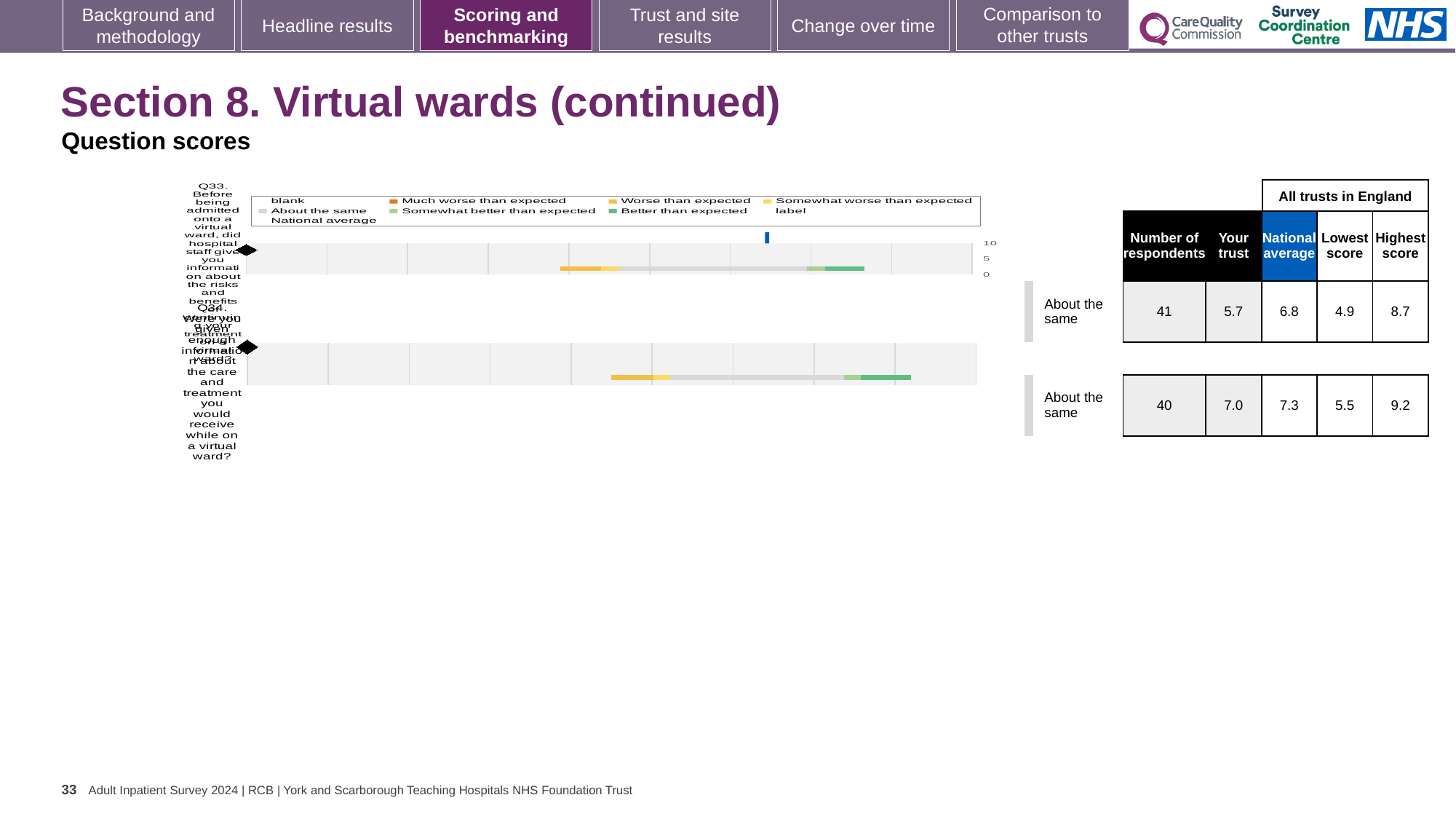
Which question has the higher 'Your trust' score, Q33 or Q34? Q34 What is the lowest score among all trusts in England for Q34? 5.5 What is the highest score among all trusts in England for Q33? 8.7 By how much does the national average for Q34 exceed the trust's score for Q34? 0.3 Which question has the larger number of respondents, Q33 or Q34? Q33 What benchmark category is shown for Q33? About the same What is the national average score for Q33? 6.8 What kind of chart is used to show the question scores? Bar chart What is the 'Your trust' score for Q34 (enough information about care and treatment on a virtual ward)? 7.0 What is the difference between the highest and lowest scores for Q33 across all trusts in England? 3.8 How many questions are plotted in the chart? 2 How many respondents answered Q33 (information about the risks and benefits of a virtual ward)? 41